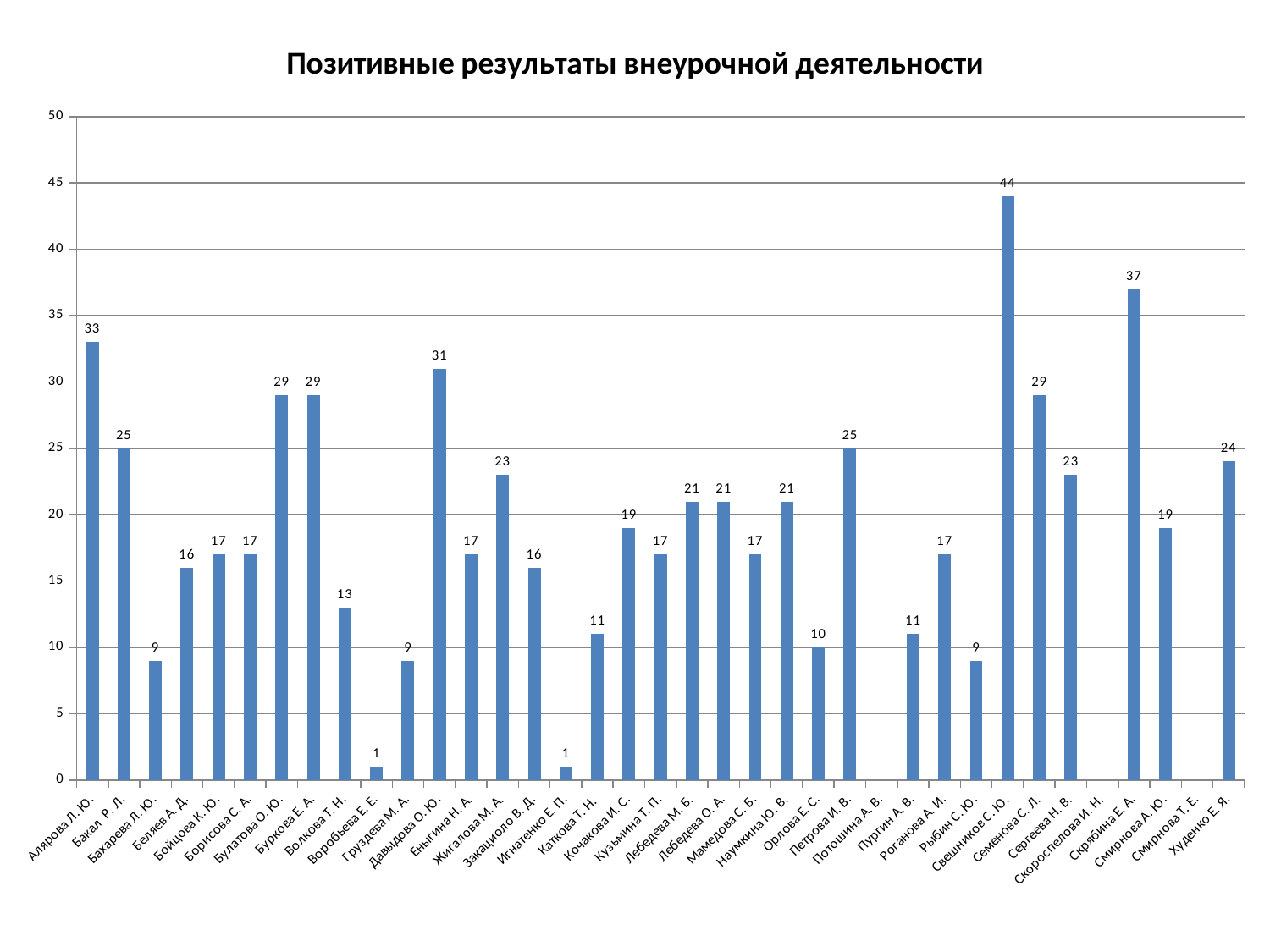
Which is larger, the value for Бакал Р. Л. or the value for Орлова Е. С.? Бакал Р. Л. What is the title of the chart? Позитивные результаты внеурочной деятельности What is the value for Худенко Е. Я.? 24 What is the value for Свешников С. Ю.? 44 What kind of chart is shown on the slide? Bar chart What is the difference between the values for Скрябина Е. А. and Алярова Л. Ю.? 4 What is the difference between the values for Свешников С. Ю. and Семенова С. Л.? 15 Which is larger, the value for Жигалова М. А. or the value for Кочакова И. С.? Жигалова М. А. What is the value for Давыдова О. Ю.? 31 Is the value for Скрябина Е. А. greater or less than 35? greater What is the value for Волкова Т. Н.? 13 Which category has the highest value? Свешников С. Ю.